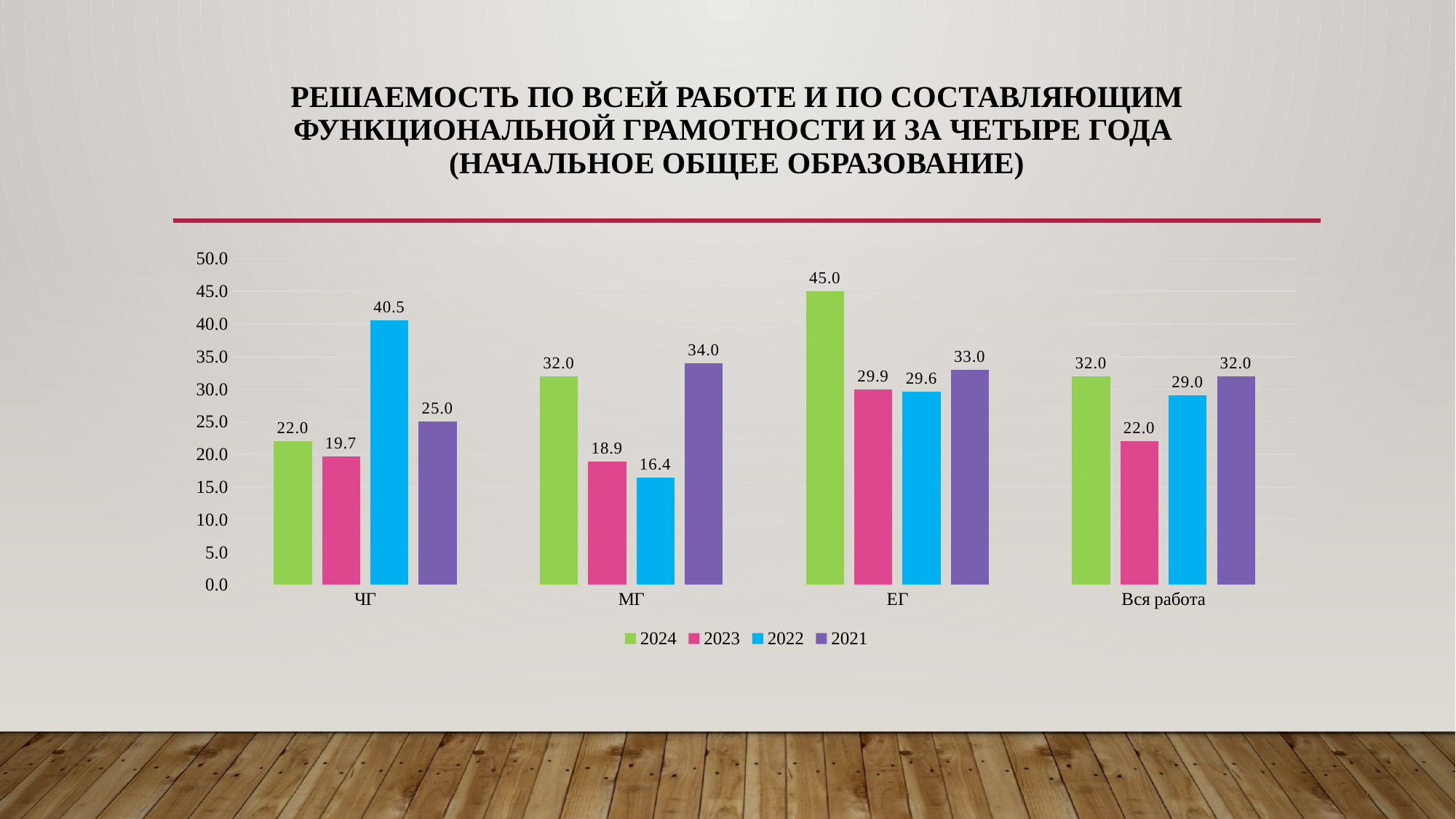
Which colour represents the 2022 series in the legend? Blue What is the value for 2022 in the Вся работа category? 29.0 What kind of chart is shown on the slide? Bar chart How many categories are shown on the x axis? 4 What is the value for 2024 in the ЕГ category? 45.0 What is the difference between the 2024 and 2023 values in the ЕГ category? 15.1 Which year has the lowest value in the ЧГ category? 2023 How many series does the legend list? 4 What is the value for 2022 in the ЧГ category? 40.5 Which is larger in the МГ category: the 2024 value or the 2021 value? 2021 What is the value for 2023 in the МГ category? 18.9 Which year has the highest value in the МГ category? 2021